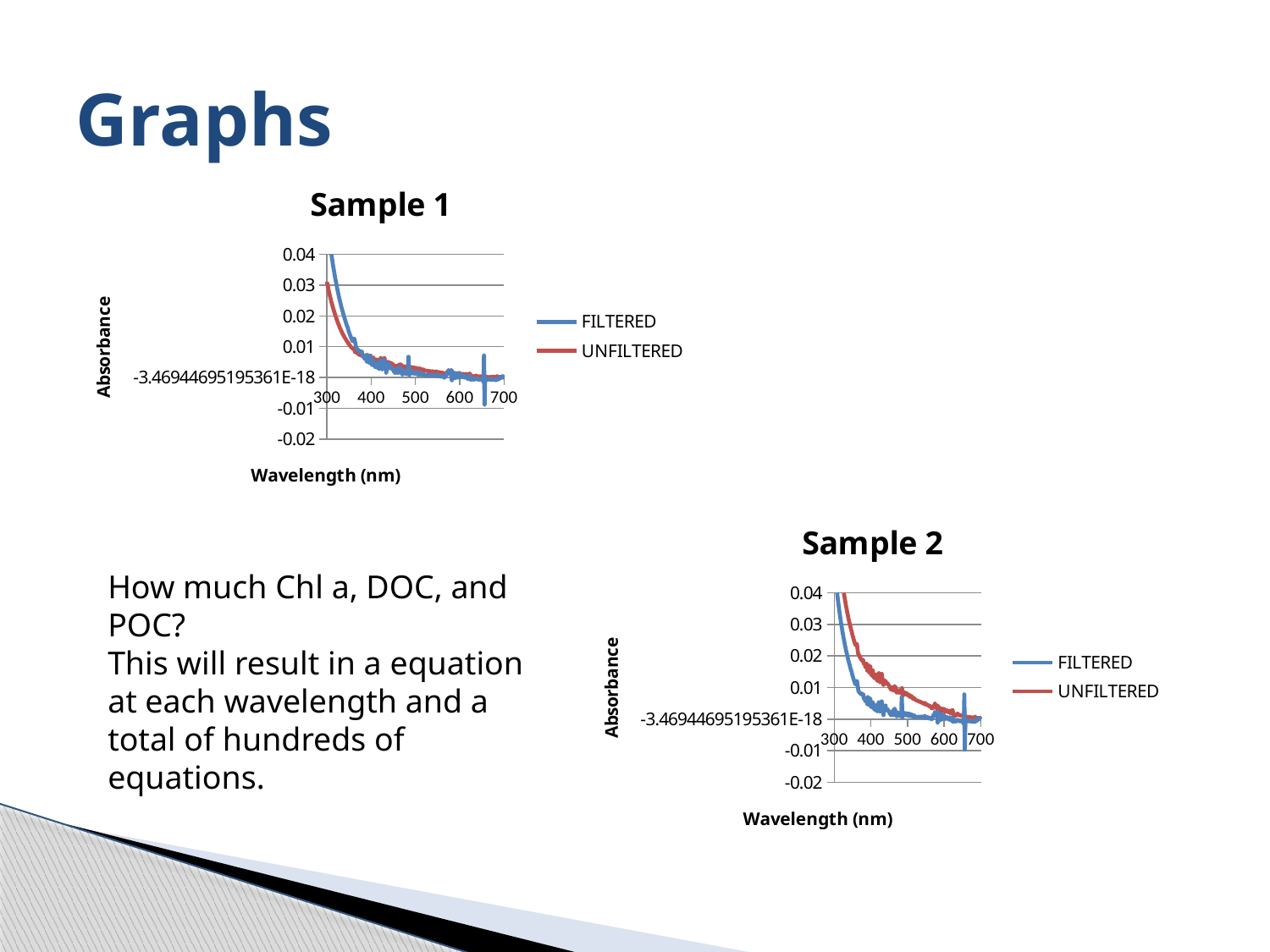
In the Sample 1 chart, at 300 nm, which series has the higher absorbance, FILTERED or UNFILTERED? FILTERED In the Sample 1 chart, do the absorbance values rise or fall as wavelength increases from 300 to 700 nm? fall What is the x-axis label of the Sample 2 chart? Wavelength (nm) What kind of chart is the Sample 1 chart? line chart In the Sample 1 chart, which colour is used for the UNFILTERED series? red In the Sample 2 chart, does the UNFILTERED series rise or fall as wavelength increases? fall How many charts are shown on the slide? 2 In the Sample 2 chart, at 400 nm, which series has the higher absorbance, FILTERED or UNFILTERED? UNFILTERED In the Sample 2 chart, is the FILTERED absorbance at 600 nm greater or less than 0.01? less In the Sample 1 chart, is the FILTERED absorbance at 300 nm greater or less than 0.03? greater In the Sample 2 chart, is the UNFILTERED absorbance at 500 nm greater or less than 0.01? less How many series does the legend of the Sample 2 chart list? 2